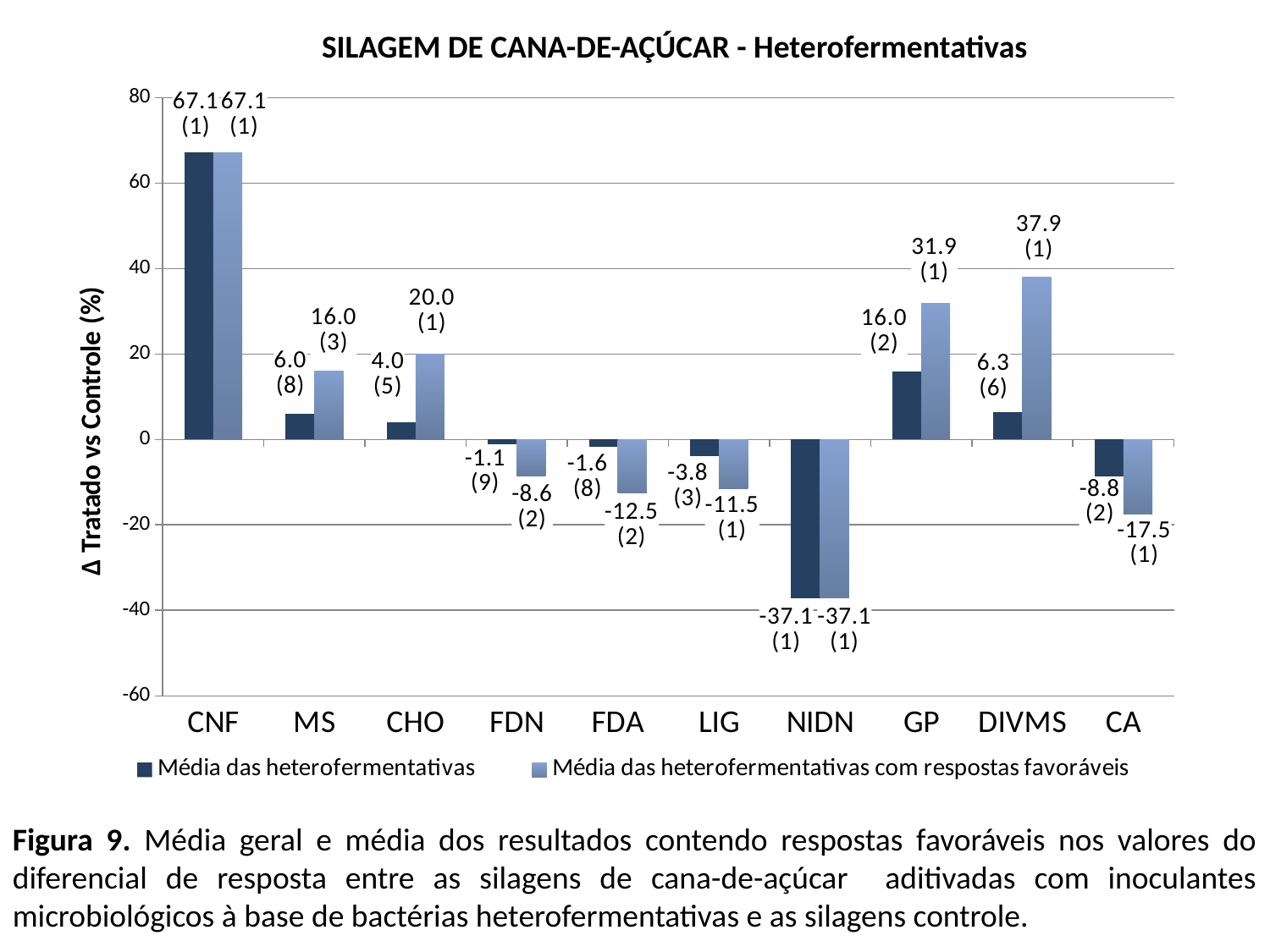
Which category has the highest value in the 'Média das heterofermentativas' series? CNF How many series does the legend list? 2 What is the difference between the two series' values for GP? 15.9 What is the value for CA in the 'Média das heterofermentativas com respostas favoráveis' series? -17.5 How many categories are shown on the x axis of the chart? 10 What is the value for CNF in the 'Média das heterofermentativas' series? 67.1 What is the value for NIDN in the 'Média das heterofermentativas' series? -37.1 Which category has the lowest value in the 'Média das heterofermentativas com respostas favoráveis' series? NIDN What is the value for DIVMS in the 'Média das heterofermentativas com respostas favoráveis' series? 37.9 What is the title of the chart? SILAGEM DE CANA-DE-AÇÚCAR - Heterofermentativas What type of chart is shown on the slide? bar chart Which is larger for CHO: the 'Média das heterofermentativas' value or the 'Média das heterofermentativas com respostas favoráveis' value? Média das heterofermentativas com respostas favoráveis